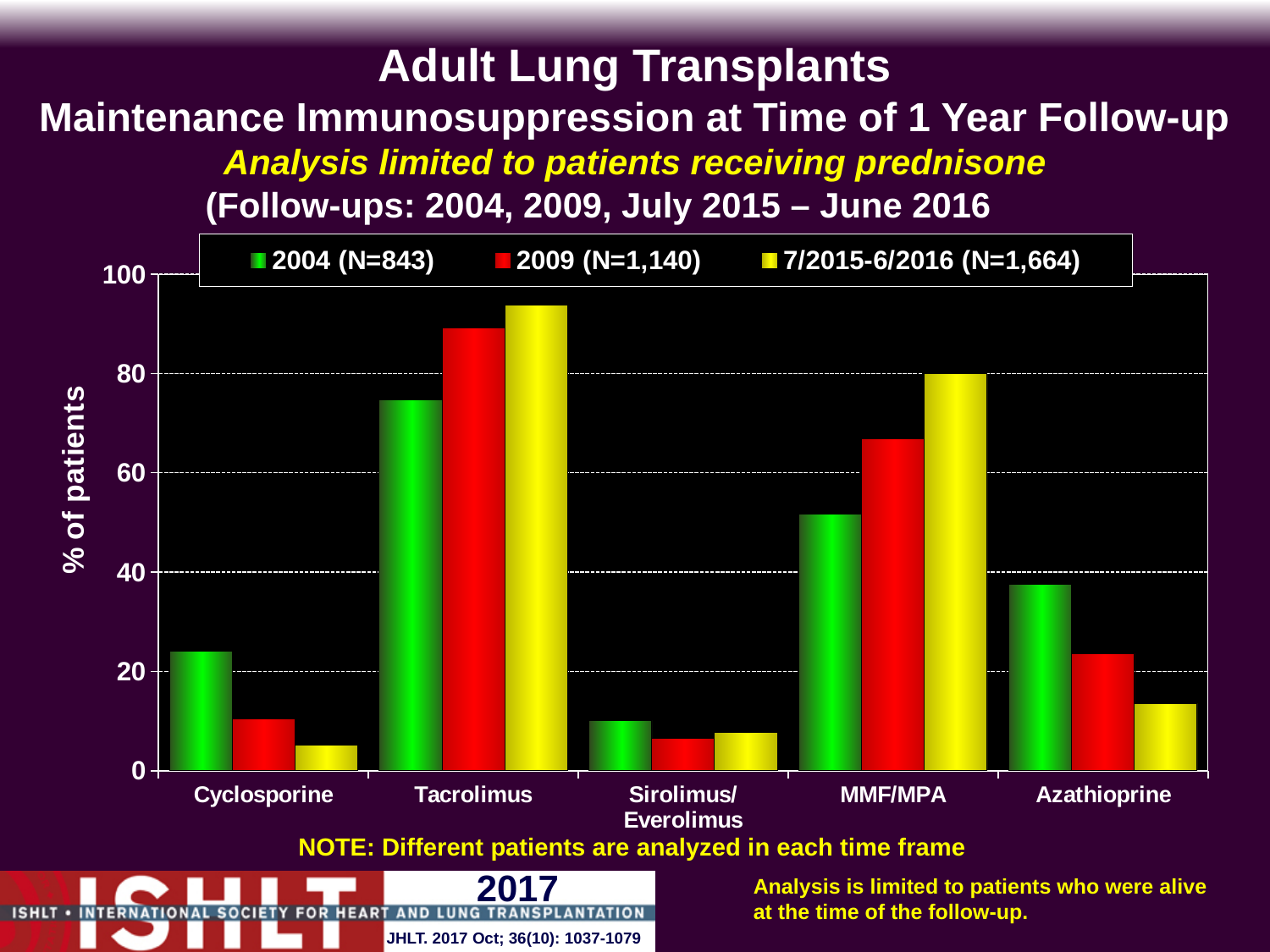
What is the label on the y axis of the chart? % of patients Is the value for Sirolimus/Everolimus in 2004 (N=843) greater or less than 20? less How many drug categories are shown on the x axis? 5 What kind of chart is shown on the slide? bar chart Is the value for Tacrolimus in 2009 (N=1,140) greater or less than 80? greater Is the value for Azathioprine in 7/2015-6/2016 (N=1,664) greater or less than 20? less Which drug category has the tallest bar in the chart? Tacrolimus How many series does the legend list? 3 Do the values for Tacrolimus rise or fall from 2004 to 7/2015-6/2016? rise For the 2004 (N=843) series, which is larger: Cyclosporine or Azathioprine? Azathioprine Which drug category has the lowest value for the 2004 (N=843) series? Sirolimus/Everolimus